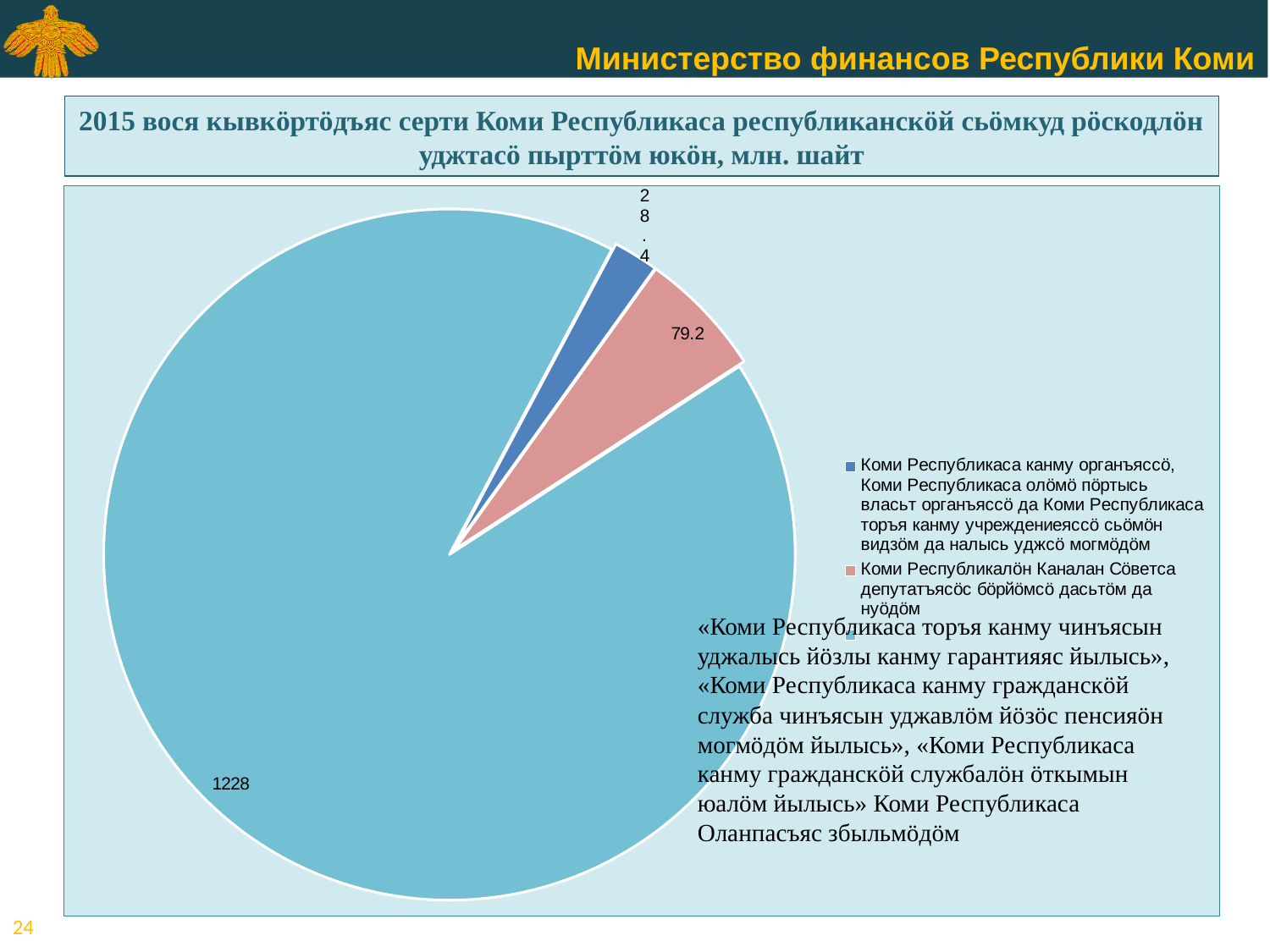
What is the value of the smallest slice of the pie chart? 28.4 What kind of chart is shown on the slide? pie chart What is the value of the largest slice of the pie chart? 1228 In what units are the values in the chart expressed, according to the slide title? млн. шайт What is the value of the dark blue slice (Коми Республикаса канму органъяссö ...)? 28.4 What is the difference between the pink slice (79.2) and the dark blue slice (28.4)? 50.8 Which is larger: the slice valued 79.2 or the slice valued 28.4? 79.2 What is the total of all three slices in the pie chart? 1335.6 What colour is the largest slice of the pie chart? light blue (teal) What is the value of the pink slice labelled 'Коми Республикалöн Каналан Сöветса депутатъясöс бöрйöмсö дасьтöм да нуöдöм'? 79.2 How many slices does the pie chart have? 3 What is the difference between the largest slice (1228) and the pink slice (79.2)? 1148.8